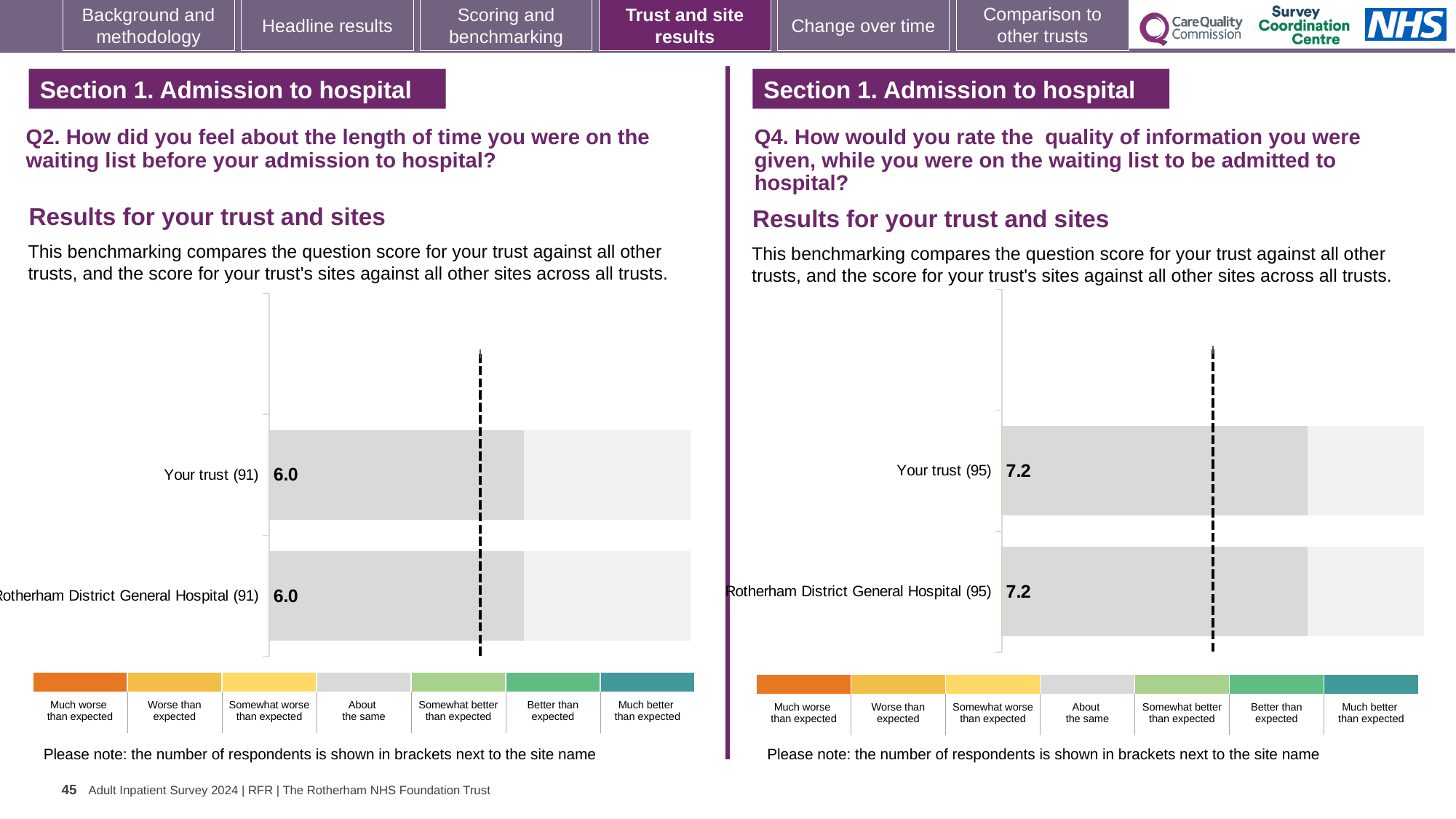
What kind of chart is used for the Q2 results on the left? Bar chart In the right chart (Q4), what is the difference between the score for Your trust and the score for Rotherham District General Hospital? 0.0 In the right chart (Q4), what is the score for Rotherham District General Hospital? 7.2 In the left chart (Q2), what is the difference between the score for Your trust and the score for Rotherham District General Hospital? 0.0 How many bars are plotted in the right chart (Q4)? 2 Is the score for Your trust in the right chart (Q4) larger or smaller than the score for Your trust in the left chart (Q2)? Larger In the left chart (Q2), what is the score for Your trust? 6.0 In the left chart (Q2), how many respondents are shown in brackets next to Your trust? 91 In the right chart (Q4), how many respondents are shown in brackets next to Rotherham District General Hospital? 95 How many bars are plotted in the left chart (Q2)? 2 In the left chart (Q2), what is the score for Rotherham District General Hospital? 6.0 In the right chart (Q4), what is the score for Your trust? 7.2